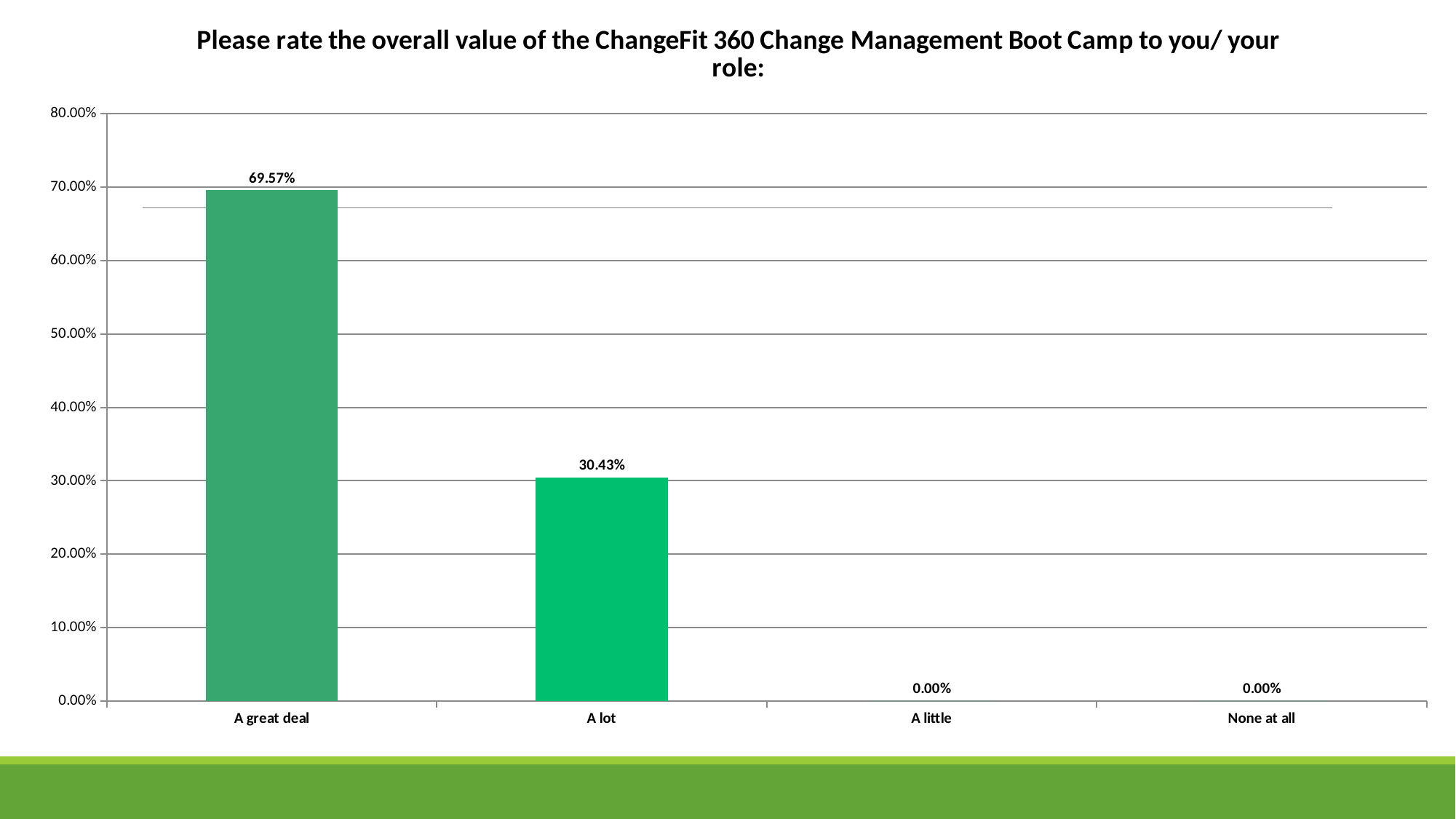
What is the value for "A little"? 0.00% How many categories are shown on the x axis? 4 Do the values rise or fall from left to right along the x axis? Fall Is the value for "A lot" greater or less than 40.00%? less What kind of chart is shown on the slide? Bar chart What is the value for "A great deal"? 69.57% What is the value for "None at all"? 0.00% What is the difference between the values for "A great deal" and "A lot"? 39.14% What is the value for "A lot"? 30.43% Which is larger, the value for "A great deal" or the value for "A lot"? A great deal Which category has the highest value? A great deal What is the title of the chart? Please rate the overall value of the ChangeFit 360 Change Management Boot Camp to you/ your role: